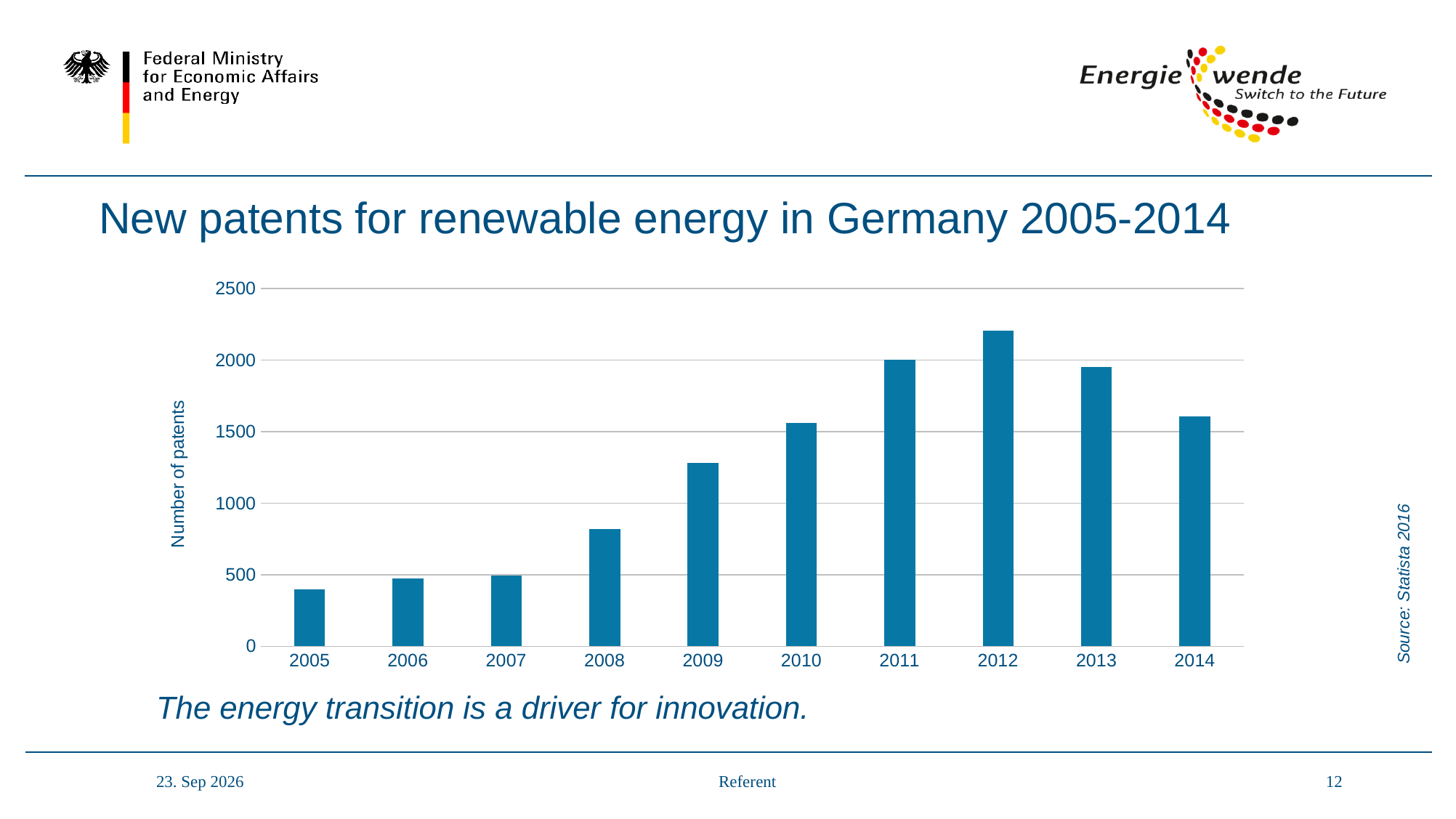
Which year has more patents, 2007 or 2008? 2008 Is the value for 2012 greater or less than 2000? greater Do the values rise or fall from 2005 to 2012? rise Which year has more patents, 2009 or 2010? 2010 Is the value for 2005 greater or less than 500? less What is the label of the y axis? Number of patents Which year has the lowest number of patents? 2005 Is the value for 2009 greater or less than 1000? greater What kind of chart is shown on the slide? bar chart Which year has the highest number of patents? 2012 How many years are shown on the x axis of the chart? 10